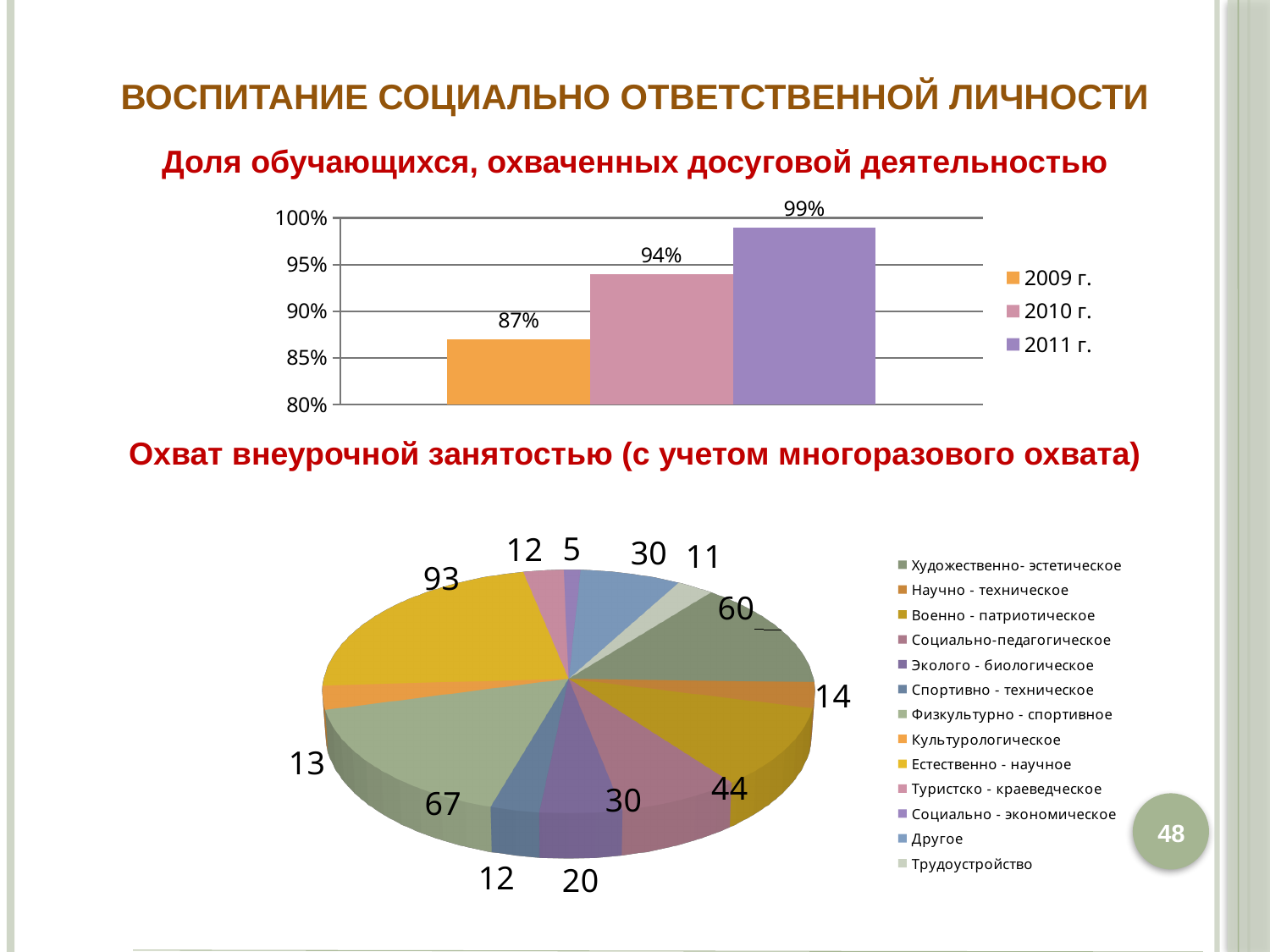
In the bar chart 'Доля обучающихся, охваченных досуговой деятельностью', what is the difference between the values for 2010 г. and 2009 г.? 7% How many series does the legend of the bar chart 'Доля обучающихся, охваченных досуговой деятельностью' list? 3 What kind of chart is the top chart 'Доля обучающихся, охваченных досуговой деятельностью'? bar chart In the bar chart 'Доля обучающихся, охваченных досуговой деятельностью', what is the value for 2011 г.? 99% In the bar chart 'Доля обучающихся, охваченных досуговой деятельностью', which year has the lowest value? 2009 г. In the pie chart 'Охват внеурочной занятостью (с учетом многоразового охвата)', what is the largest value shown on a slice? 93 What kind of chart is the bottom chart 'Охват внеурочной занятостью (с учетом многоразового охвата)'? pie chart How many categories does the legend of the pie chart 'Охват внеурочной занятостью (с учетом многоразового охвата)' list? 13 In the bar chart 'Доля обучающихся, охваченных досуговой деятельностью', do the values rise or fall from 2009 г. to 2011 г.? rise In the bar chart 'Доля обучающихся, охваченных досуговой деятельностью', which year has the highest value? 2011 г. In the bar chart 'Доля обучающихся, охваченных досуговой деятельностью', what is the value for 2009 г.? 87% In the pie chart 'Охват внеурочной занятостью (с учетом многоразового охвата)', what is the smallest value shown on a slice? 5